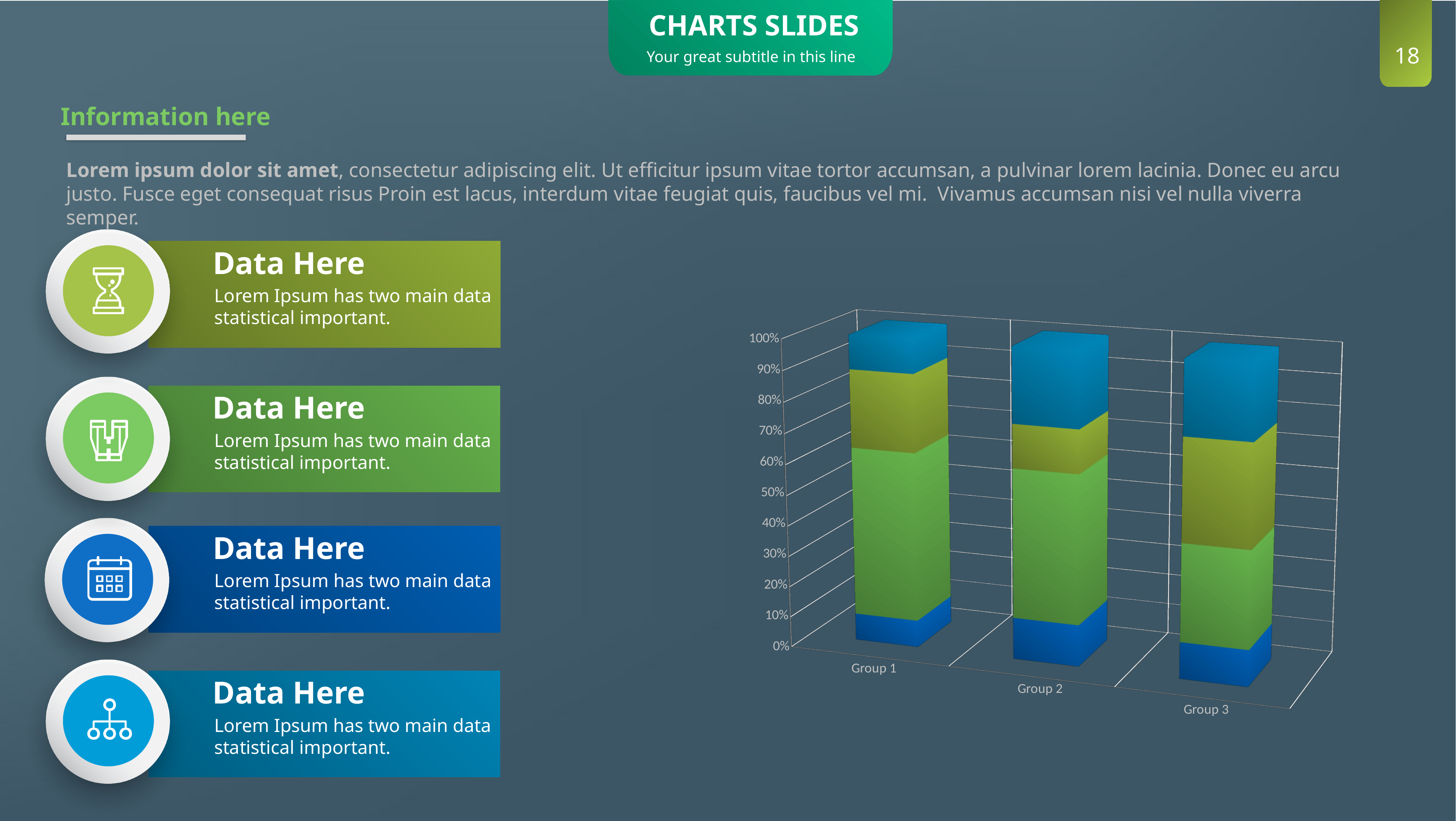
Which category label appears furthest to the right on the x axis? Group 3 Is the dark blue bottom segment of the Group 2 bar greater or less than 30%? less What is the highest value shown on the vertical axis of the chart? 100% Is the light blue top segment of the Group 1 bar greater or less than 30%? less How many coloured segments does each stacked bar in the chart contain? 4 What are the category labels on the x axis of the chart? Group 1, Group 2, Group 3 Is the green segment of the Group 1 bar greater or less than 30%? greater What kind of chart is shown on the slide? bar chart How many groups (categories) are shown on the x axis of the chart? 3